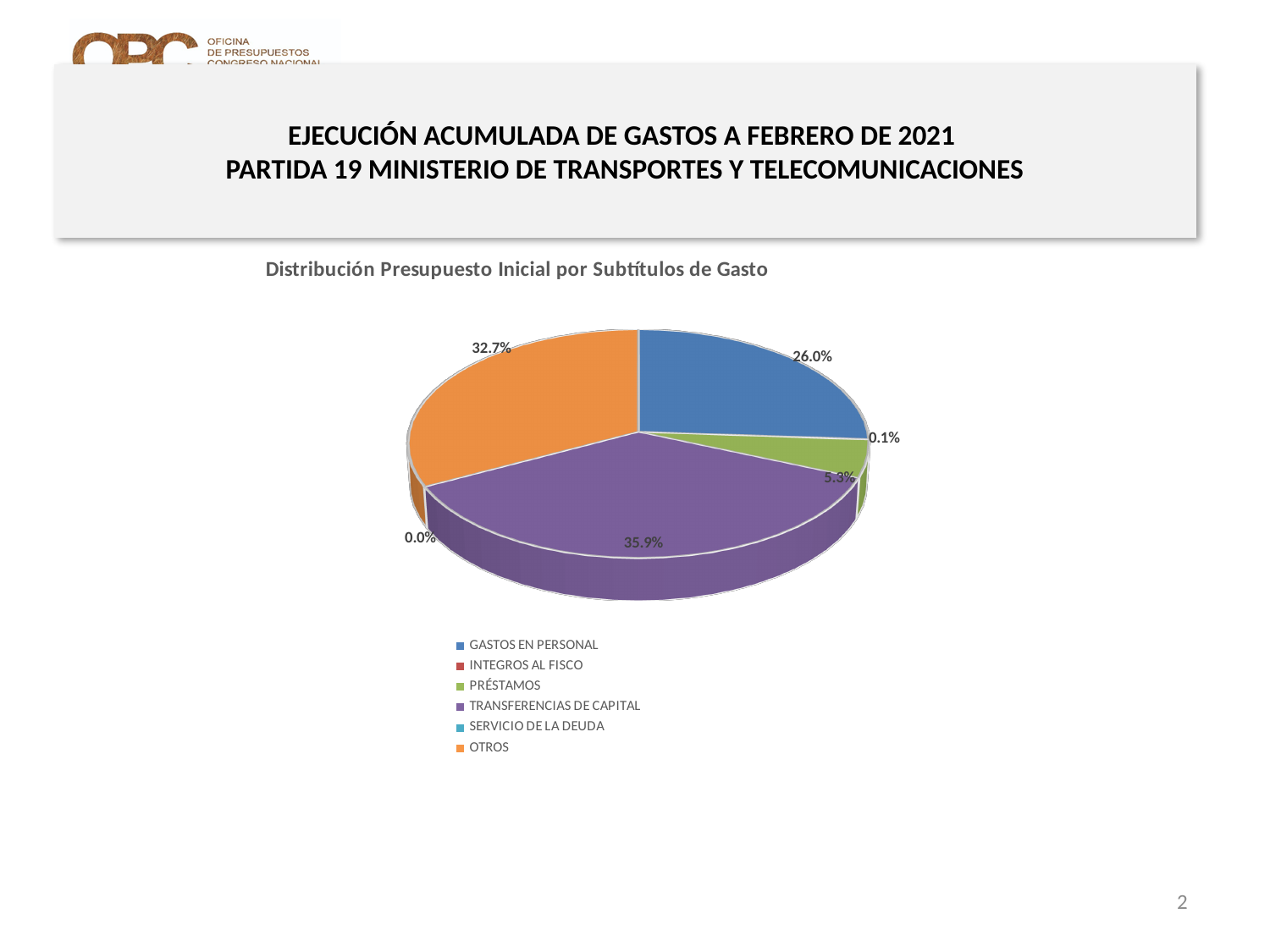
What percentage share does OTROS have? 32.7% What is the difference in percentage points between TRANSFERENCIAS DE CAPITAL and OTROS? 3.2 What percentage share does PRÉSTAMOS have? 5.3% What is the title of the chart? Distribución Presupuesto Inicial por Subtítulos de Gasto Which category has the largest share of the pie? TRANSFERENCIAS DE CAPITAL What percentage share does GASTOS EN PERSONAL have? 26.0% What colour is the slice for TRANSFERENCIAS DE CAPITAL? Purple Which category has the smallest share of the pie? SERVICIO DE LA DEUDA How many categories does the legend list? 6 What type of chart is shown on the slide? Pie chart Which has a larger share, GASTOS EN PERSONAL or OTROS? OTROS What percentage share does TRANSFERENCIAS DE CAPITAL have? 35.9%